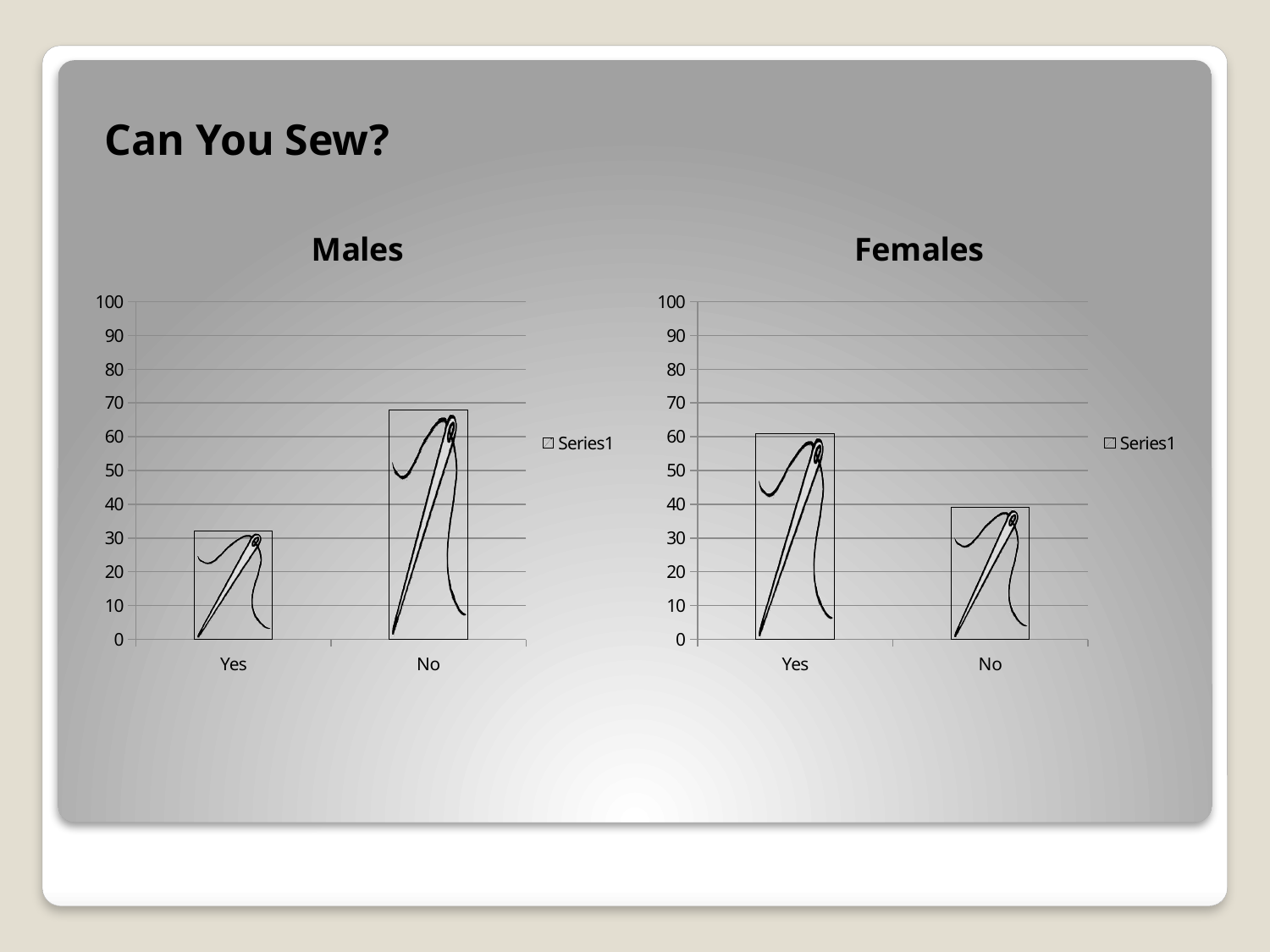
In the Females chart, which category has the higher value? Yes In the Females chart, is the value for No greater or less than 50? less In the Males chart, which category has the lower value? Yes In the Males chart, is the value for Yes greater or less than 40? less In the Males chart, which category has the higher value? No What is the title of the chart on the right side of the slide? Females In the Males chart, is the value for No greater or less than 60? greater In the Females chart, which category has the lower value? No How many series does the legend of the Males chart list? 1 How many categories are shown on the x axis of the Females chart? 2 What kind of chart is the Males chart? bar chart